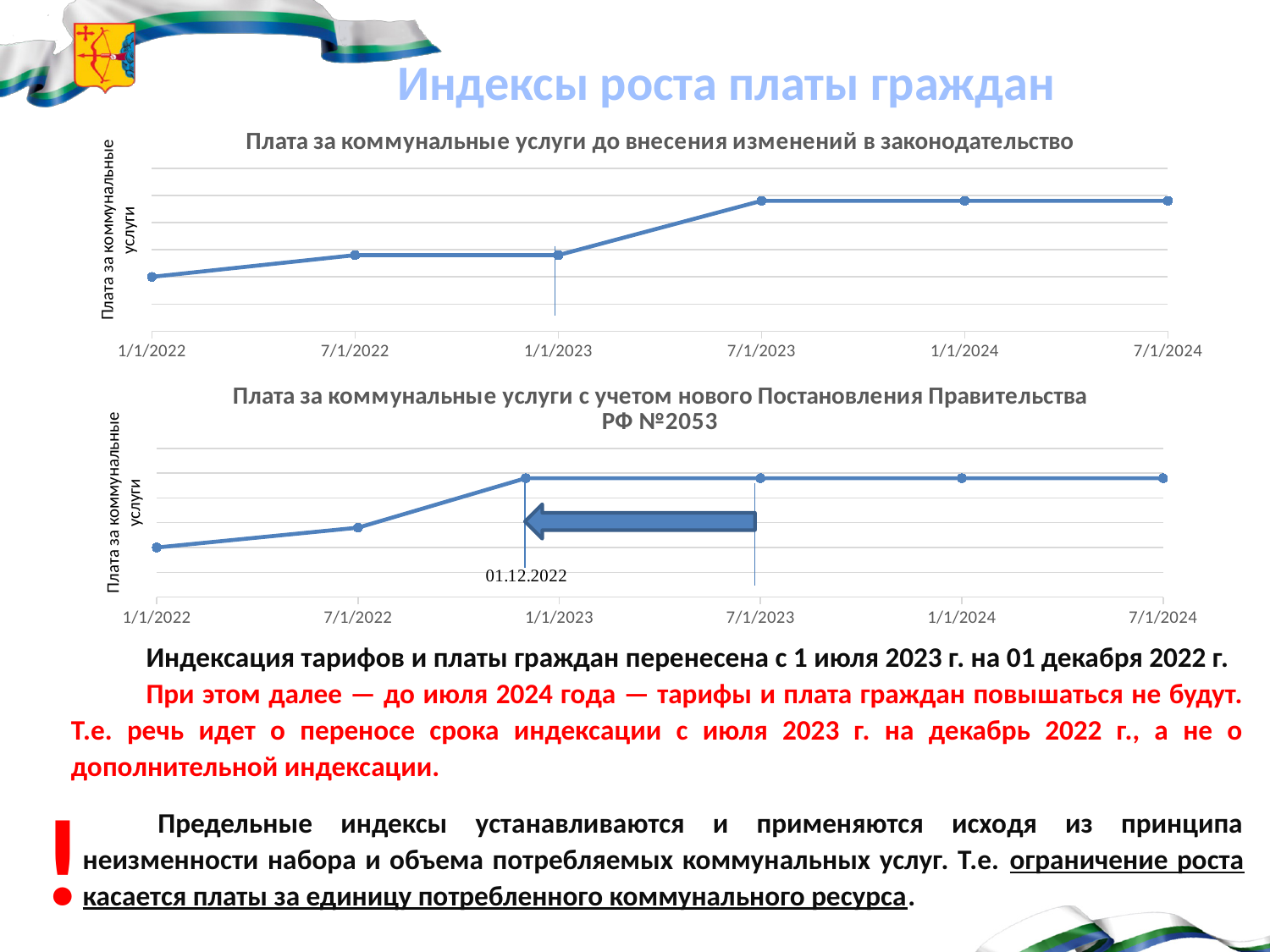
In the top chart, is the value at 7/1/2023 higher or lower than the value at 1/1/2023? higher How many date labels are shown on the x axis of the bottom chart? 6 In the bottom chart, does the line rise, fall or stay flat between 1/1/2023 and 7/1/2024? stays flat What kind of chart is the top chart, titled "Плата за коммунальные услуги до внесения изменений в законодательство"? line chart In the top chart, which x-axis date has the lowest plotted value? 1/1/2022 What is the y-axis label of the top chart? Плата за коммунальные услуги How many data points are plotted on the top chart? 6 What kind of chart is the bottom chart, titled "Плата за коммунальные услуги с учетом нового Постановления Правительства РФ №2053"? line chart In the top chart, does the line rise or fall between 1/1/2022 and 7/1/2023? rises What date is annotated below the line in the bottom chart? 01.12.2022 What is the first date label on the x axis of the top chart? 1/1/2022 In the bottom chart, is the value at 1/1/2023 higher or lower than the value at 7/1/2022? higher